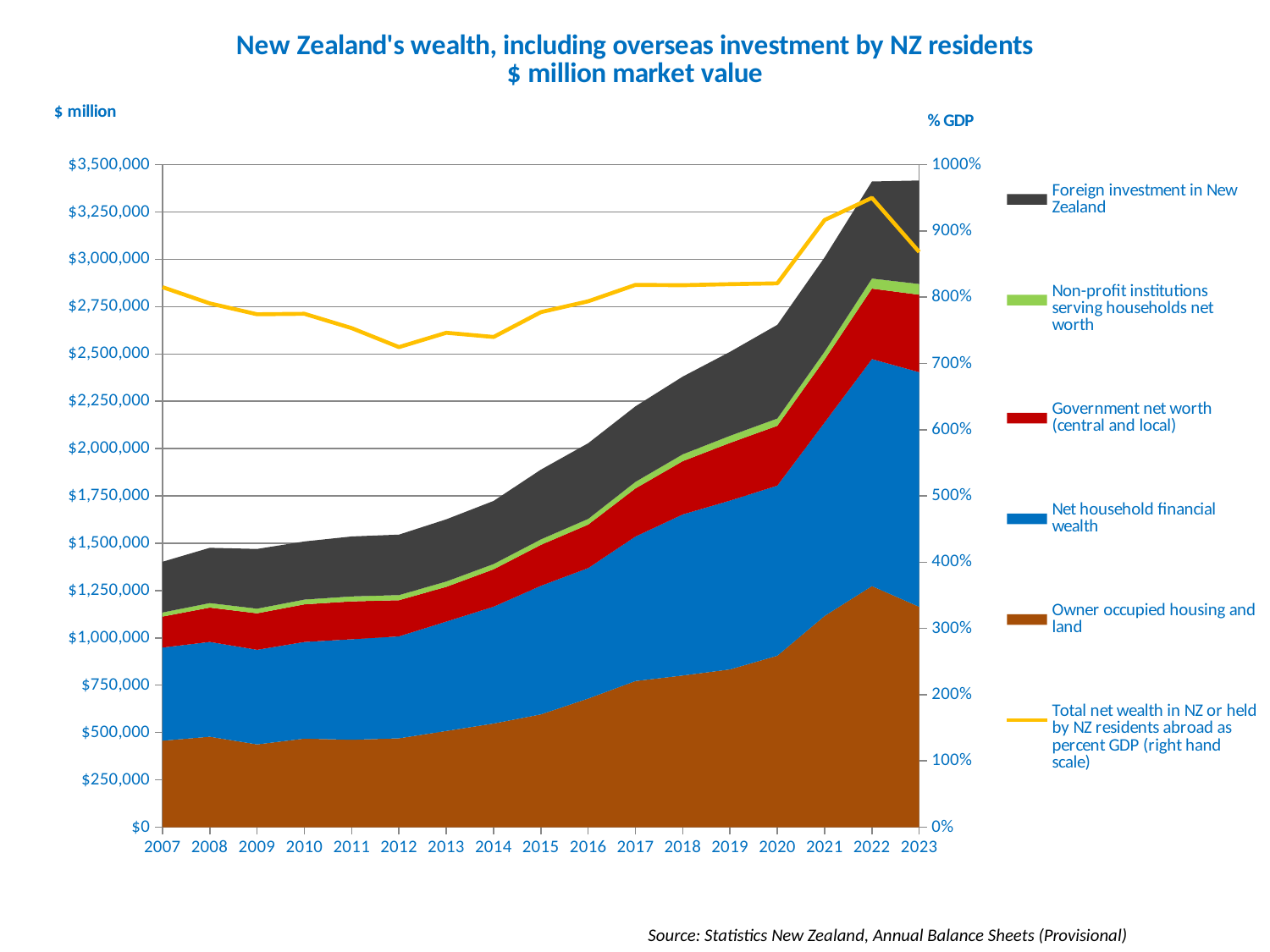
What kind of chart is shown on the slide? A stacked area chart with a line on a secondary axis Is the total net wealth as percent of GDP in 2023 greater or less than 900%? less Which series is plotted on the right-hand (% GDP) axis? Total net wealth in NZ or held by NZ residents abroad as percent GDP Is the total height of the stacked areas in 2023 greater or less than $3,000,000 million? greater How many years are plotted along the x axis? 17 Is the total height of the stacked areas in 2007 greater or less than $1,500,000 million? less In which year does the total net wealth as percent of GDP line reach its lowest point? 2012 Does the total stacked wealth in $ million generally rise or fall from 2007 to 2023? rise In which year does the total net wealth as percent of GDP line reach its highest point? 2022 What is the first year shown on the x axis? 2007 How many series does the legend list? 6